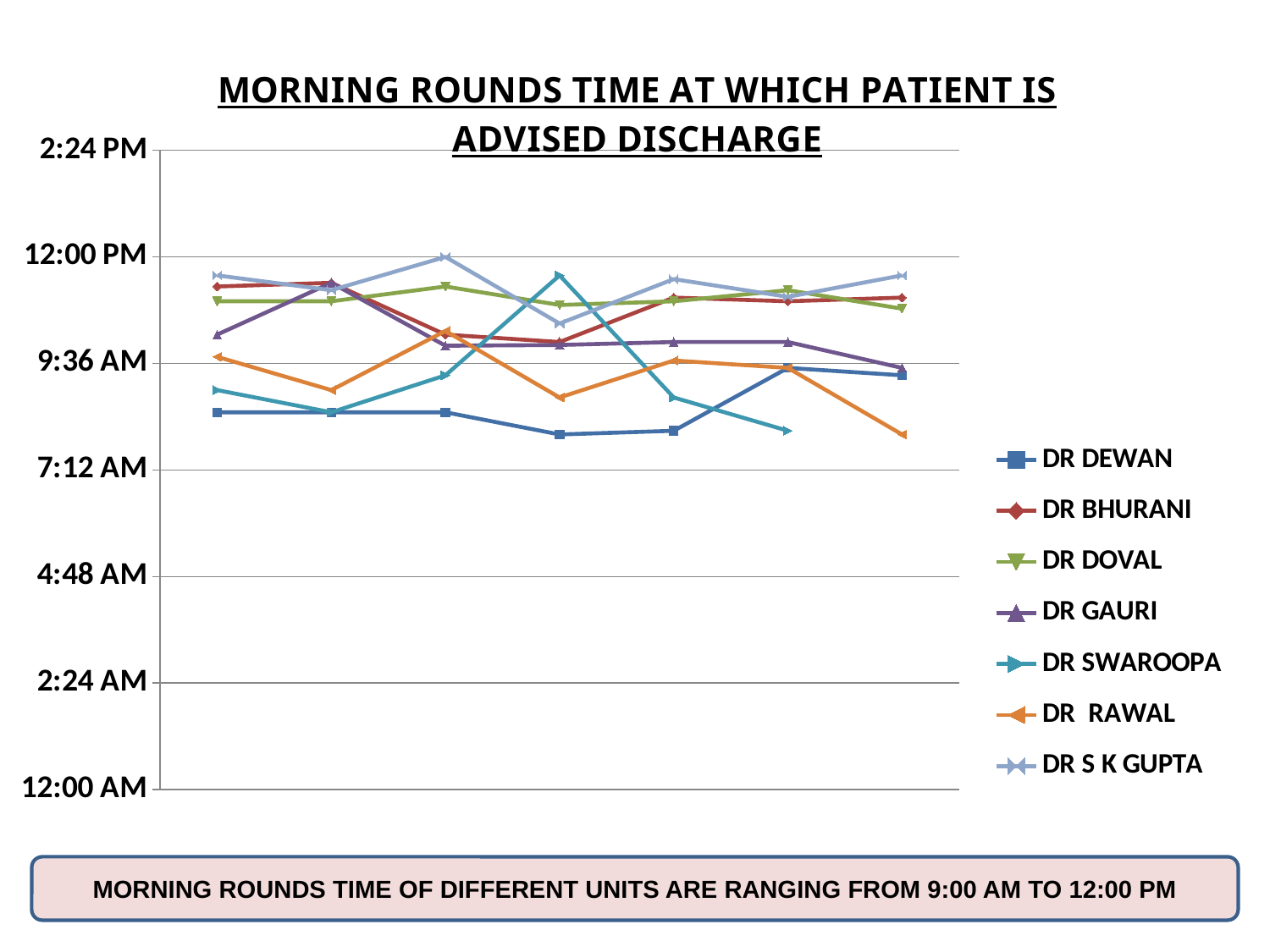
Which series reaches the highest point on the chart? DR S K GUPTA What is the title of the chart? MORNING ROUNDS TIME AT WHICH PATIENT IS ADVISED DISCHARGE How many points are plotted for the DR SWAROOPA series? 6 Which series is listed last in the legend? DR S K GUPTA Is the last value for DR DOVAL greater or less than 7:12 AM? greater At the first point on the x axis, which is higher: DR DEWAN or DR BHURANI? DR BHURANI Is the first value for DR DEWAN greater or less than 9:36 AM? less How many series does the legend list? 7 What kind of chart is shown on the slide? line chart Is the first value for DR S K GUPTA greater or less than 9:36 AM? greater How many points are plotted for the DR DEWAN series? 7